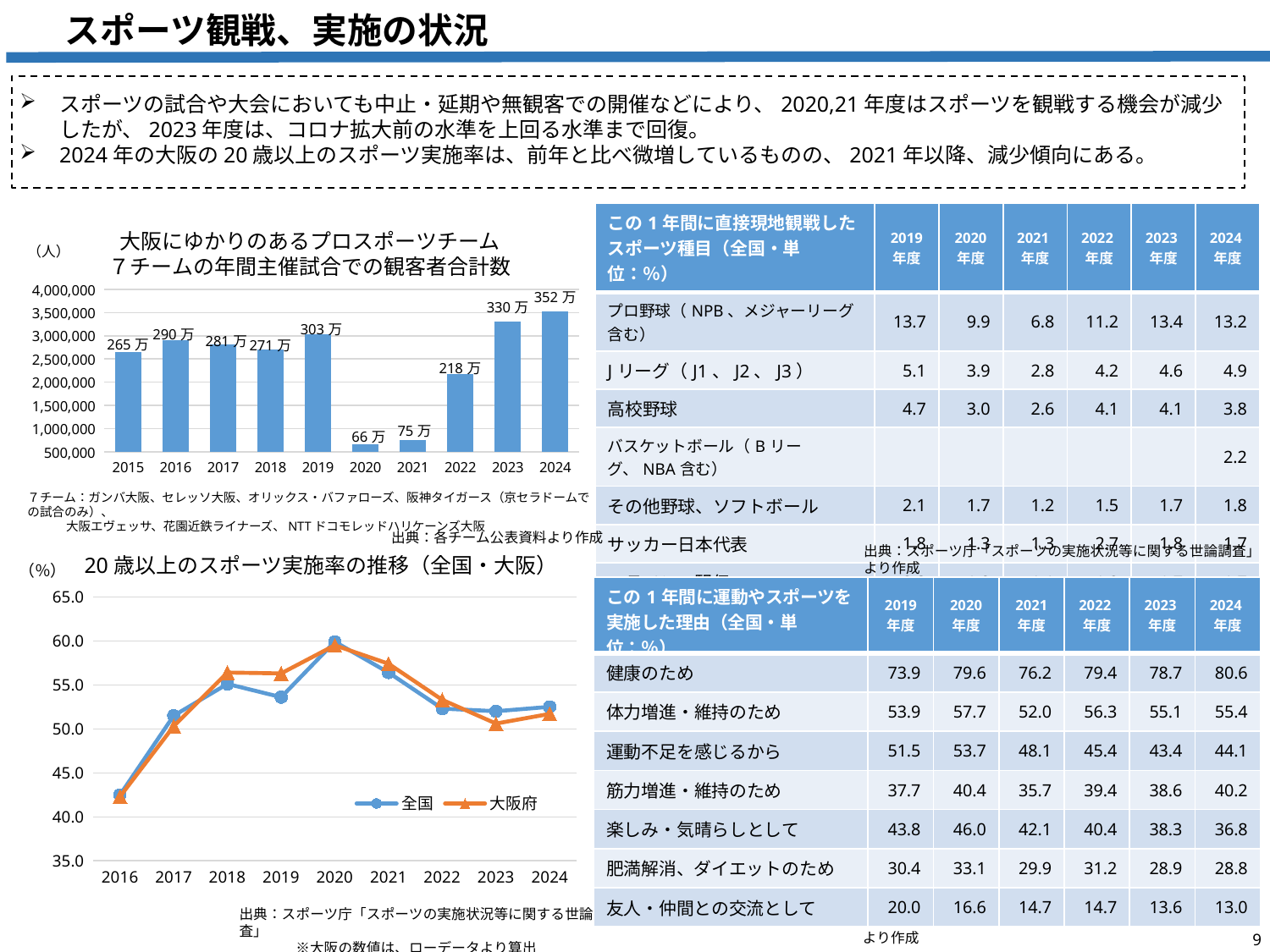
In the bar chart of spectator totals for the 7 Osaka-related pro sports teams, which year has the highest value? 2024 In the line chart of sports participation rate (20歳以上のスポーツ実施率の推移), is the 大阪府 value for 2016 greater or less than 45.0? less In the bar chart of spectator totals for the 7 Osaka-related pro sports teams, what is the value for 2022? 218万 In the line chart of sports participation rate (20歳以上のスポーツ実施率の推移), is the 全国 value for 2020 greater or less than 55.0? greater In the line chart of sports participation rate (20歳以上のスポーツ実施率の推移), does the 全国 line rise or fall from 2020 to 2023? fall What kind of chart is the top-left chart showing spectator totals for the 7 Osaka-related pro sports teams? Bar chart In the bar chart of spectator totals for the 7 Osaka-related pro sports teams, what is the difference between the 2024 and 2023 values? 22万 In the bar chart of spectator totals for the 7 Osaka-related pro sports teams, which is larger, the value for 2016 or for 2017? 2016 In the bar chart of spectator totals for the 7 Osaka-related pro sports teams, which year has the lowest value? 2020 In the bar chart of spectator totals for the 7 Osaka-related pro sports teams, what is the value for 2019? 303万 How many series does the legend list in the line chart of sports participation rate for people aged 20 and over (20歳以上のスポーツ実施率の推移)? 2 How many years are shown in the bar chart of spectator totals for the 7 Osaka-related pro sports teams? 10